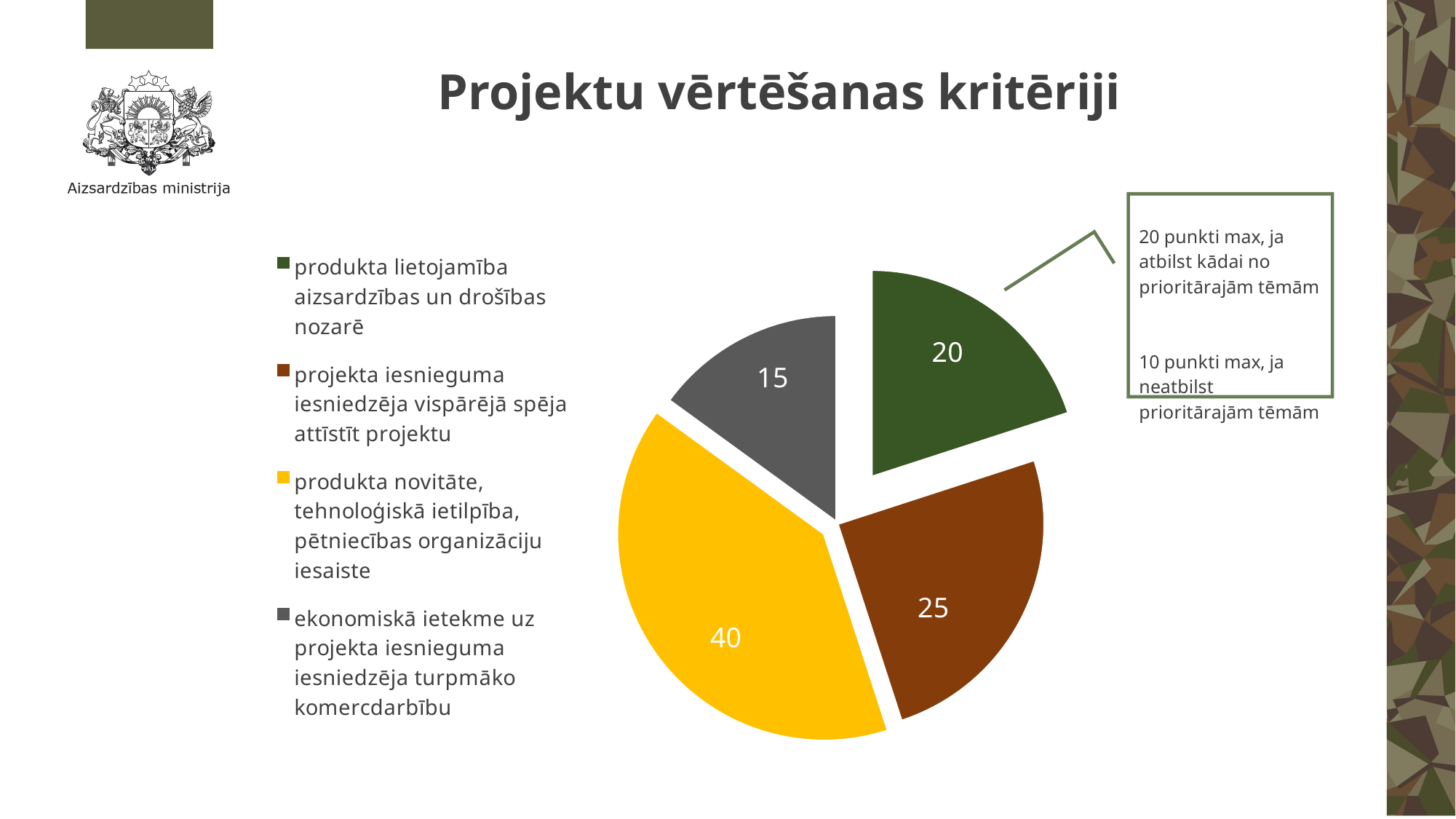
How many slices does the pie chart have? 4 What is the value of the slice for 'projekta iesnieguma iesniedzēja vispārējā spēja attīstīt projektu'? 25 What kind of chart is shown on the slide? pie chart What is the value of the slice for 'ekonomiskā ietekme uz projekta iesnieguma iesniedzēja turpmāko komercdarbību'? 15 Which is larger: the slice for 'projekta iesnieguma iesniedzēja vispārējā spēja attīstīt projektu' or the slice for 'produkta lietojamība aizsardzības un drošības nozarē'? projekta iesnieguma iesniedzēja vispārējā spēja attīstīt projektu Which category has the largest slice in the pie chart? produkta novitāte, tehnoloģiskā ietilpība, pētniecības organizāciju iesaiste What is the value of the slice for 'produkta lietojamība aizsardzības un drošības nozarē'? 20 What is the difference between the slice for 'produkta novitāte, tehnoloģiskā ietilpība, pētniecības organizāciju iesaiste' and the slice for 'ekonomiskā ietekme uz projekta iesnieguma iesniedzēja turpmāko komercdarbību'? 25 What is the value of the slice for 'produkta novitāte, tehnoloģiskā ietilpība, pētniecības organizāciju iesaiste'? 40 How many entries does the legend of the pie chart list? 4 Which category has the smallest slice in the pie chart? ekonomiskā ietekme uz projekta iesnieguma iesniedzēja turpmāko komercdarbību What colour is the slice for 'produkta novitāte, tehnoloģiskā ietilpība, pētniecības organizāciju iesaiste'? yellow